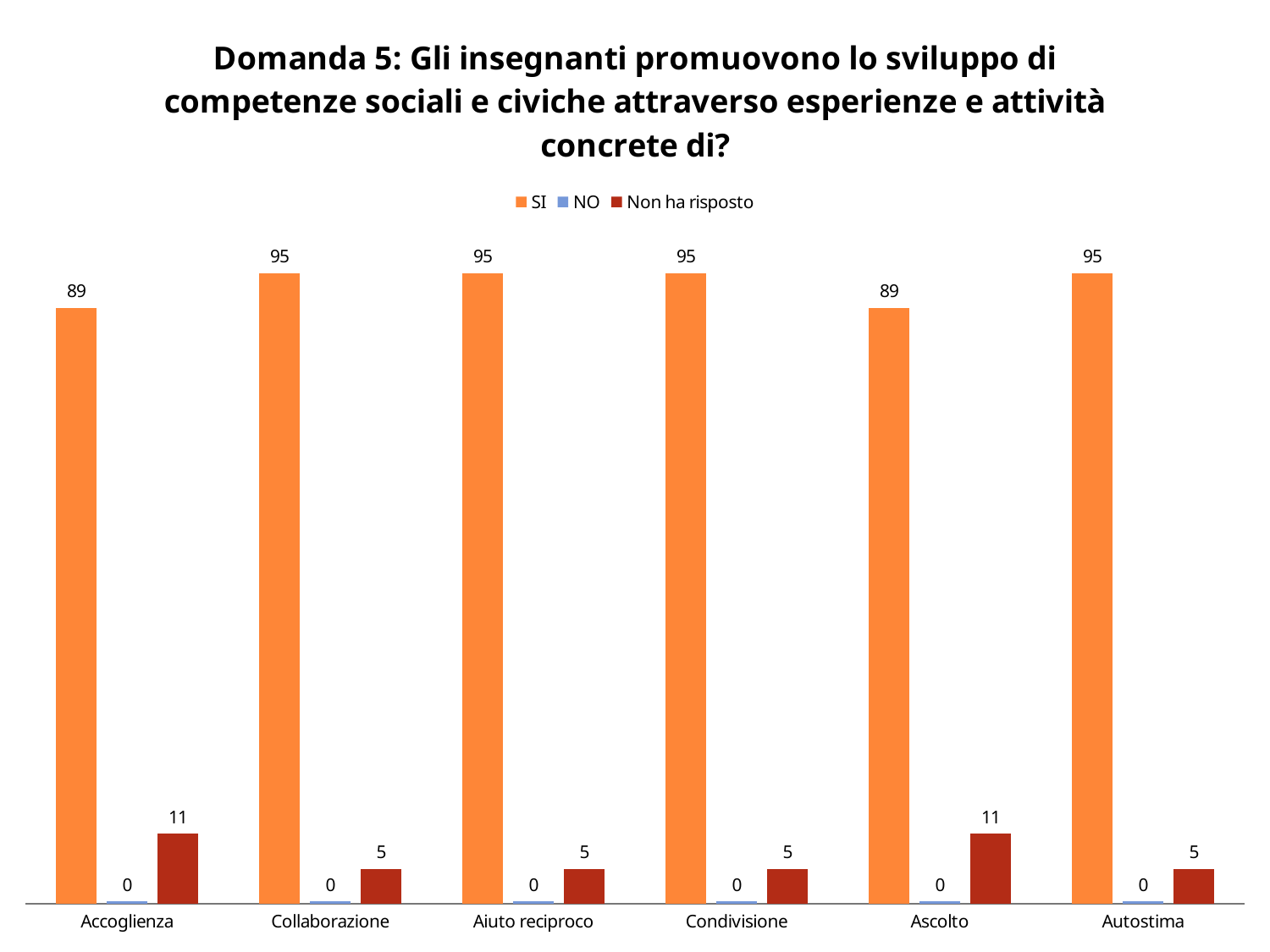
What is the difference between the SI values for Collaborazione and Ascolto? 6 How many categories are shown on the x axis? 6 What is the SI value for Accoglienza? 89 How many series does the legend list? 3 Which category has the lowest SI value, Accoglienza or Collaborazione? Accoglienza What is the difference between the Non ha risposto values for Accoglienza and Autostima? 6 What is the Non ha risposto value for Ascolto? 11 What is the NO value for Collaborazione? 0 Which series is shown in orange? SI What is the SI value for Condivisione? 95 What kind of chart is shown on the slide? bar chart Is the Non ha risposto value for Accoglienza larger or smaller than the Non ha risposto value for Aiuto reciproco? larger